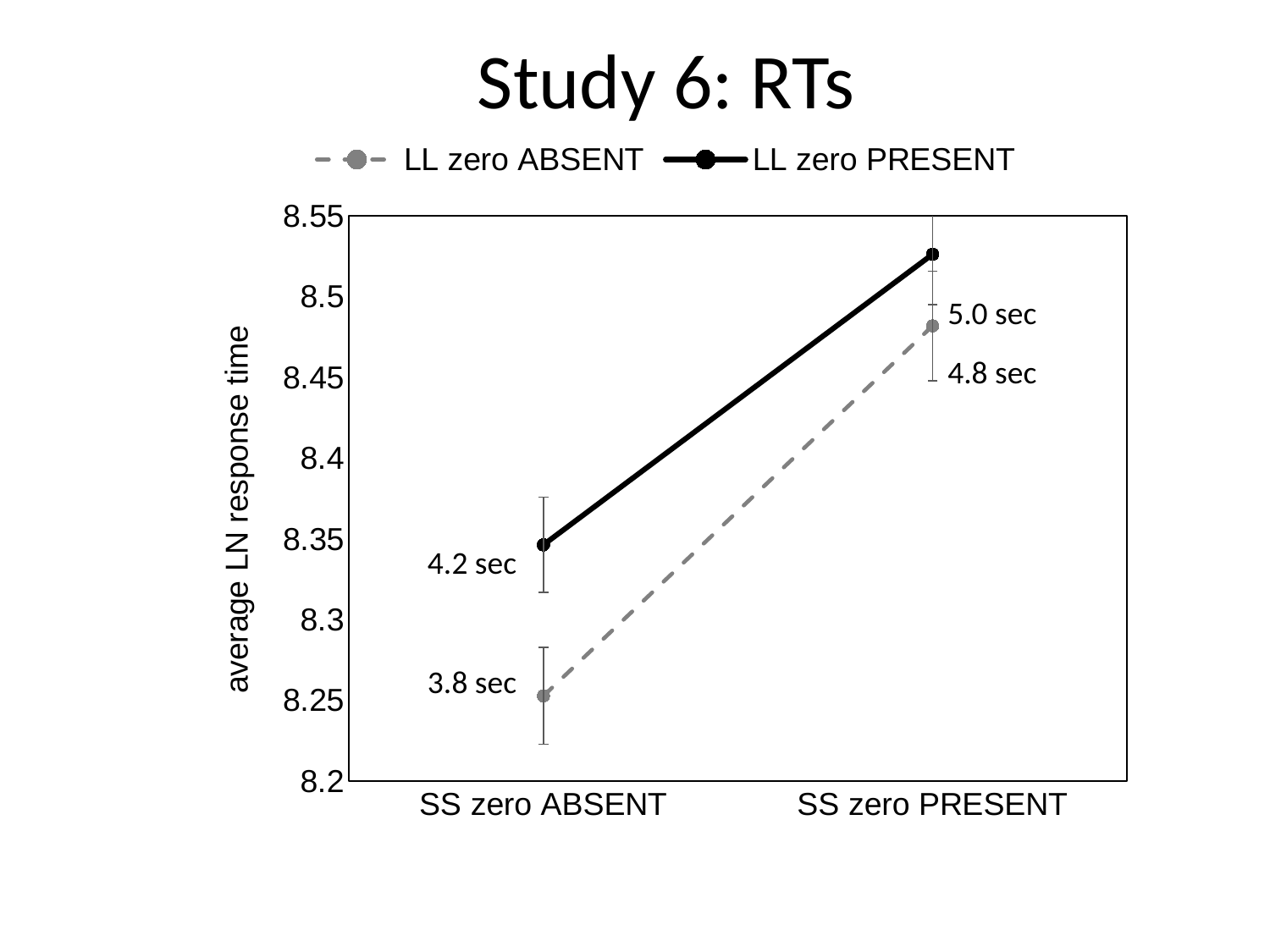
At SS zero ABSENT, which series has the higher average LN response time? LL zero PRESENT What seconds value is annotated next to the LL zero ABSENT point at SS zero PRESENT? 4.8 sec Is the LL zero ABSENT value at SS zero PRESENT greater or less than 8.5? less How many categories are shown on the x axis? 2 What is the label on the y axis? average LN response time What seconds value is annotated next to the LL zero PRESENT point at SS zero PRESENT? 5.0 sec Does the LL zero ABSENT series rise or fall from SS zero ABSENT to SS zero PRESENT? rise What kind of chart is shown on the slide? line chart Is the LL zero PRESENT value at SS zero PRESENT greater or less than 8.5? greater What is the title of the slide's chart? Study 6: RTs How many series does the legend list? 2 What seconds value is annotated next to the LL zero ABSENT point at SS zero ABSENT? 3.8 sec